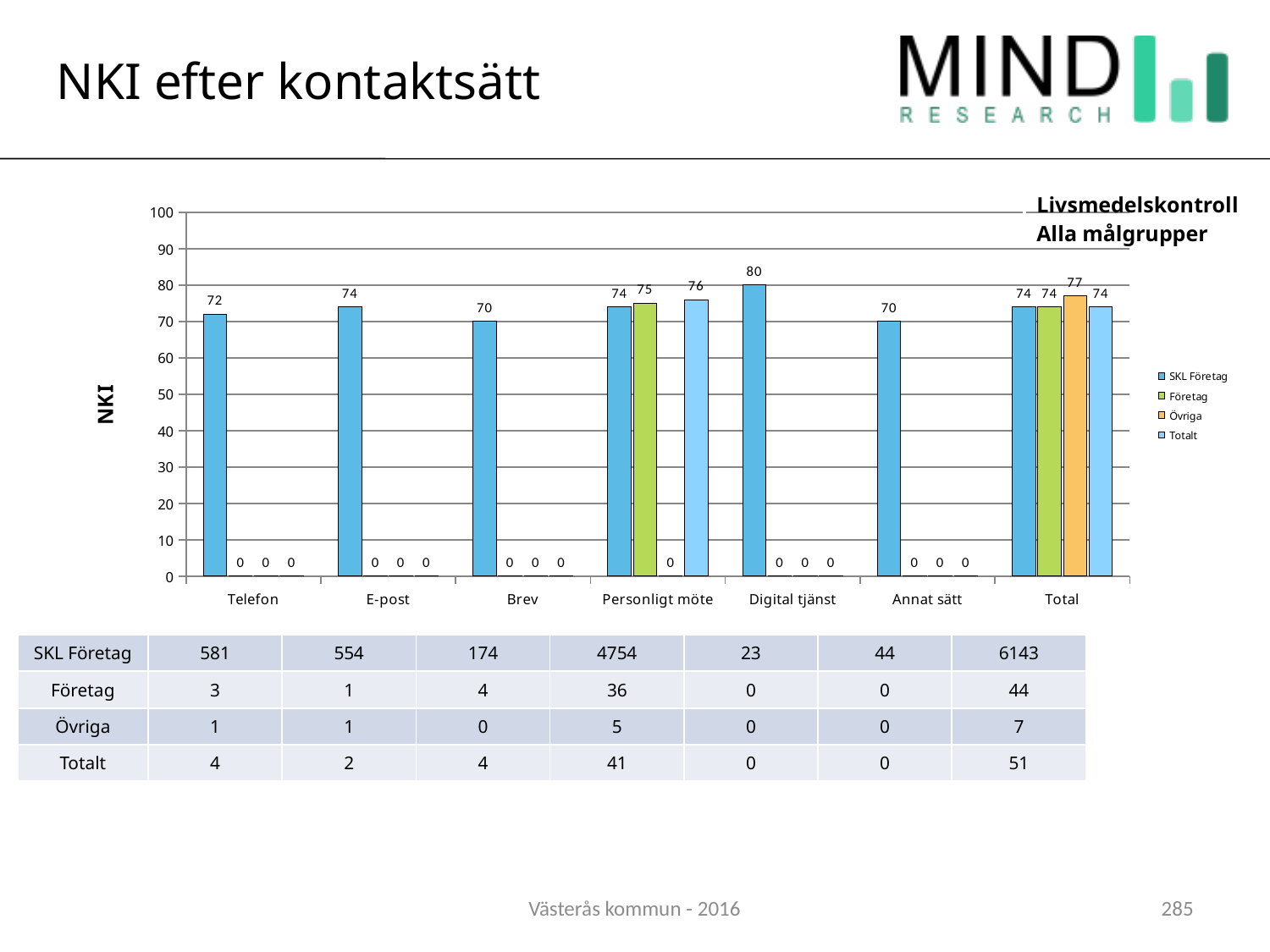
Which contact method has the highest SKL Företag value? Digital tjänst What is the Övriga value for Personligt möte? 0 What is the Totalt value for Personligt möte? 76 How many series does the legend list? 4 What is the difference between the SKL Företag values for Digital tjänst and Brev? 10 What is the label of the y axis? NKI What kind of chart is shown? bar chart What is the SKL Företag value for Digital tjänst? 80 Which is larger, the SKL Företag value for Telefon or for E-post? E-post What is the Företag value for Personligt möte? 75 What is the Övriga value for Total? 77 How many contact-method categories are shown on the x axis? 7